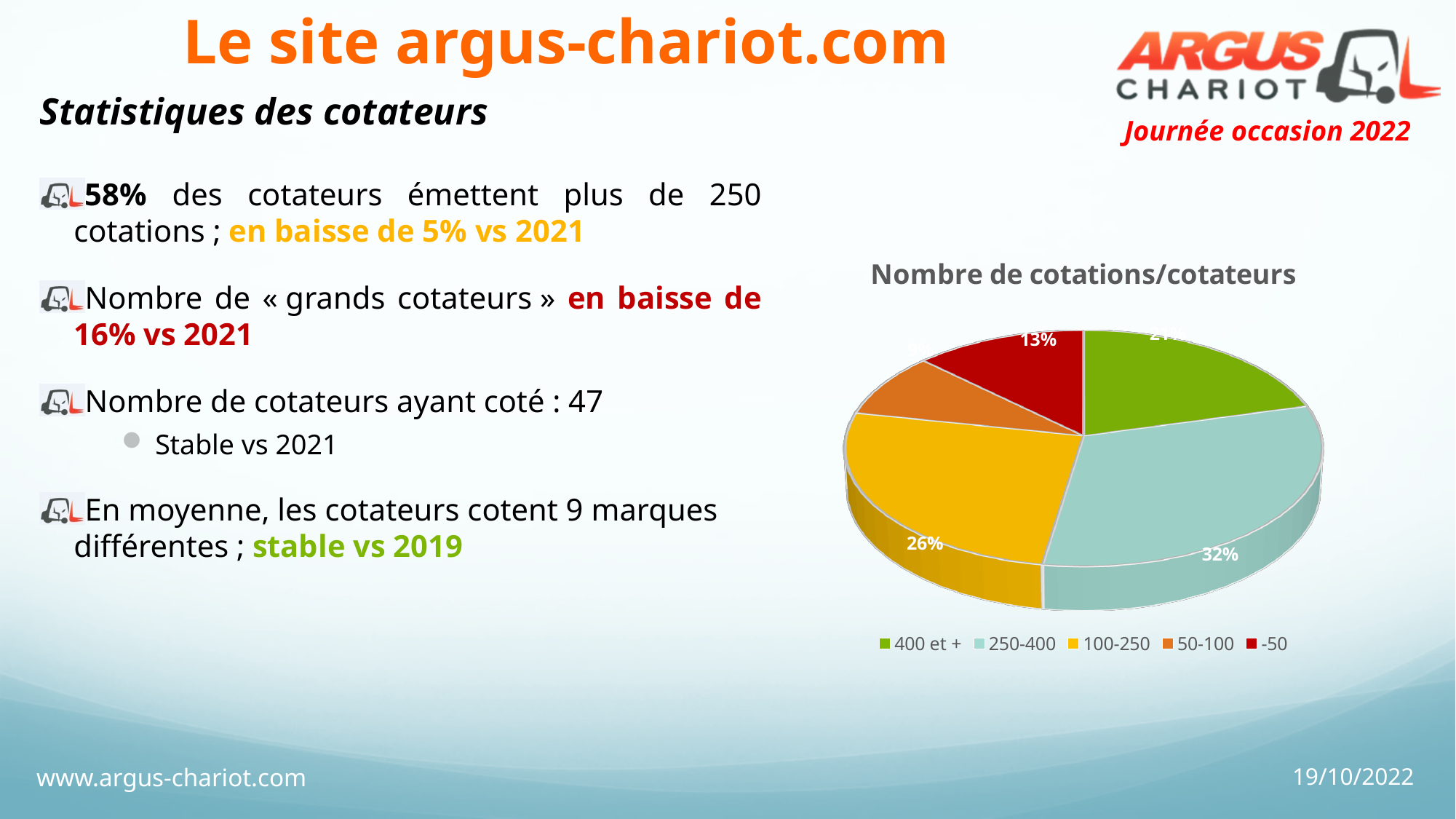
What is the title of the chart? Nombre de cotations/cotateurs Which category has a larger share: 250-400 or 100-250? 250-400 What is the difference in percentage points between the 250-400 share and the 100-250 share? 6 What colour is the slice for the 400 et + category? green What kind of chart is shown on the slide? pie chart What share of the pie does the 250-400 category represent? 32% What is the difference in percentage points between the 100-250 share and the -50 share? 13 Which category has the smallest share of the pie? 50-100 Which category has the largest share of the pie? 250-400 What share of the pie does the -50 category represent? 13% How many categories does the pie chart legend list? 5 What share of the pie does the 100-250 category represent? 26%